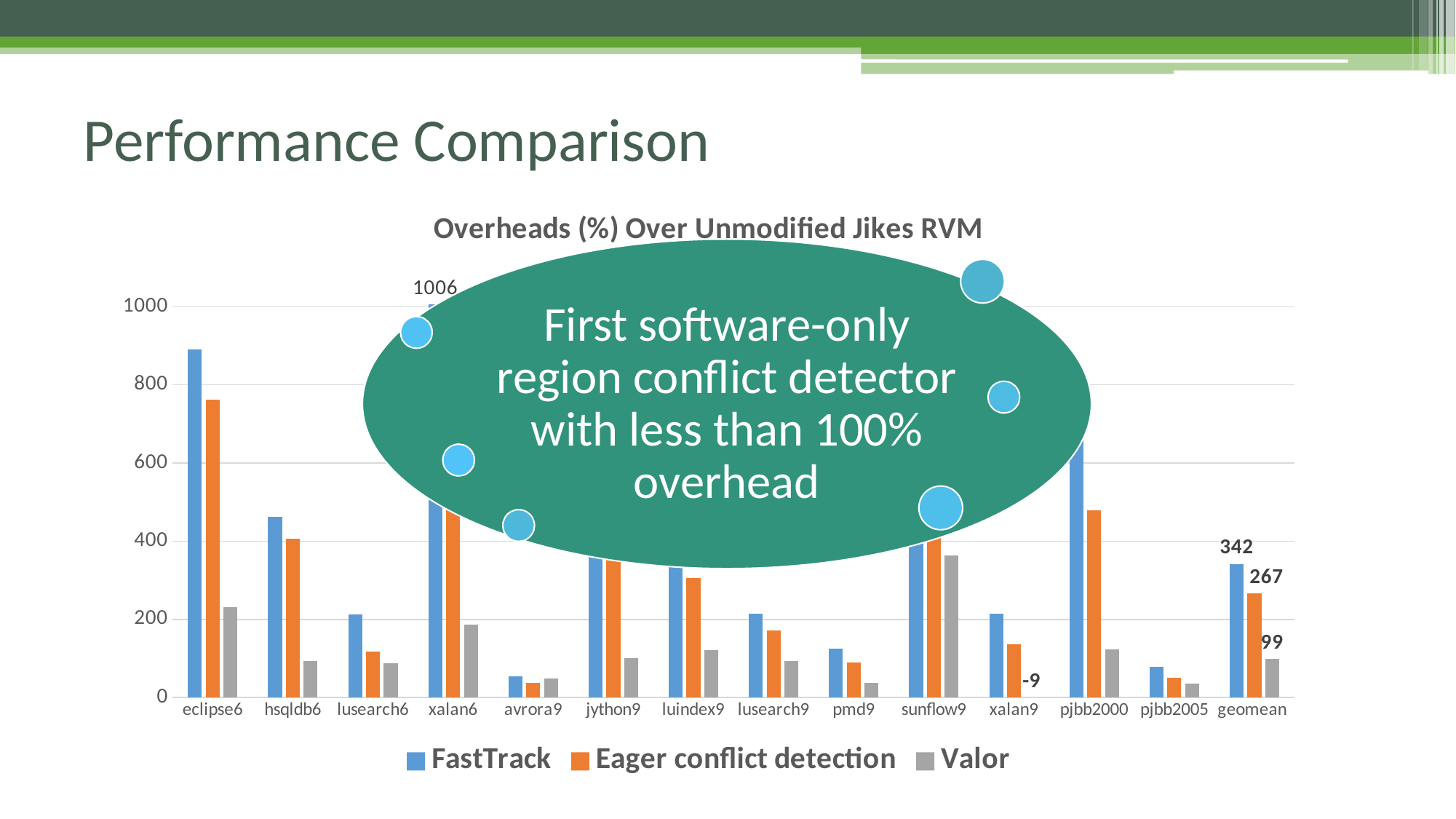
How many benchmark categories are shown on the x axis? 14 What is the FastTrack value for xalan6? 1006 What type of chart is shown on the slide? bar chart Which category has the highest FastTrack value? xalan6 What is the title of the chart? Overheads (%) Over Unmodified Jikes RVM What is the Valor value for xalan9? -9 How many series does the legend list? 3 For eclipse6, which is larger: the FastTrack value or the Eager conflict detection value? FastTrack What is the difference between the FastTrack and Valor values for geomean? 243 What is the FastTrack value for geomean? 342 What is the Eager conflict detection value for geomean? 267 Is the FastTrack value for eclipse6 greater or less than 800? greater